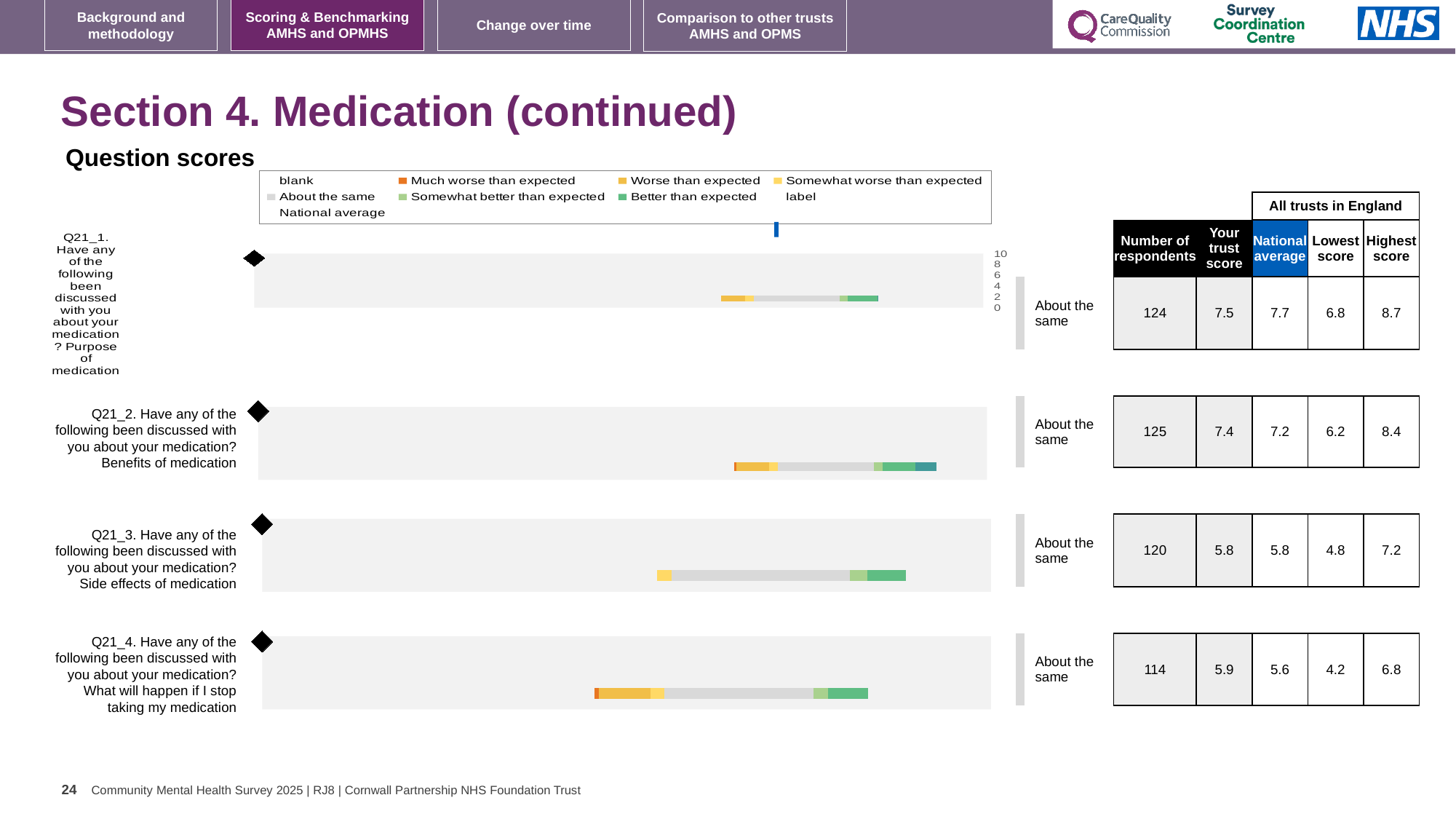
In the table beside the charts, what is 'Your trust score' for Q21_2 (Benefits of medication)? 7.4 How many question score charts (Q21_1 to Q21_4) are shown on the slide? 4 How many entries does the legend above the question score charts list? 9 What kind of chart is used to show the question scores for Q21_1 to Q21_4? bar chart Which question has the highest 'Your trust score' in the table beside the charts? Q21_1 (Purpose of medication) For Q21_1 (Purpose of medication), what is the difference between the highest score and the lowest score in the table? 1.9 Which question has the lowest number of respondents in the table beside the charts? Q21_4 (What will happen if I stop taking my medication) What colour does the legend use for 'Much worse than expected'? orange In the table beside the charts, what is the national average for Q21_4 (What will happen if I stop taking my medication)? 5.6 For Q21_2 (Benefits of medication), which is larger: 'Your trust score' or the national average? Your trust score In the table beside the charts, what is the number of respondents for Q21_1 (Purpose of medication)? 124 What benchmark category is shown next to the chart for Q21_3 (Side effects of medication)? About the same